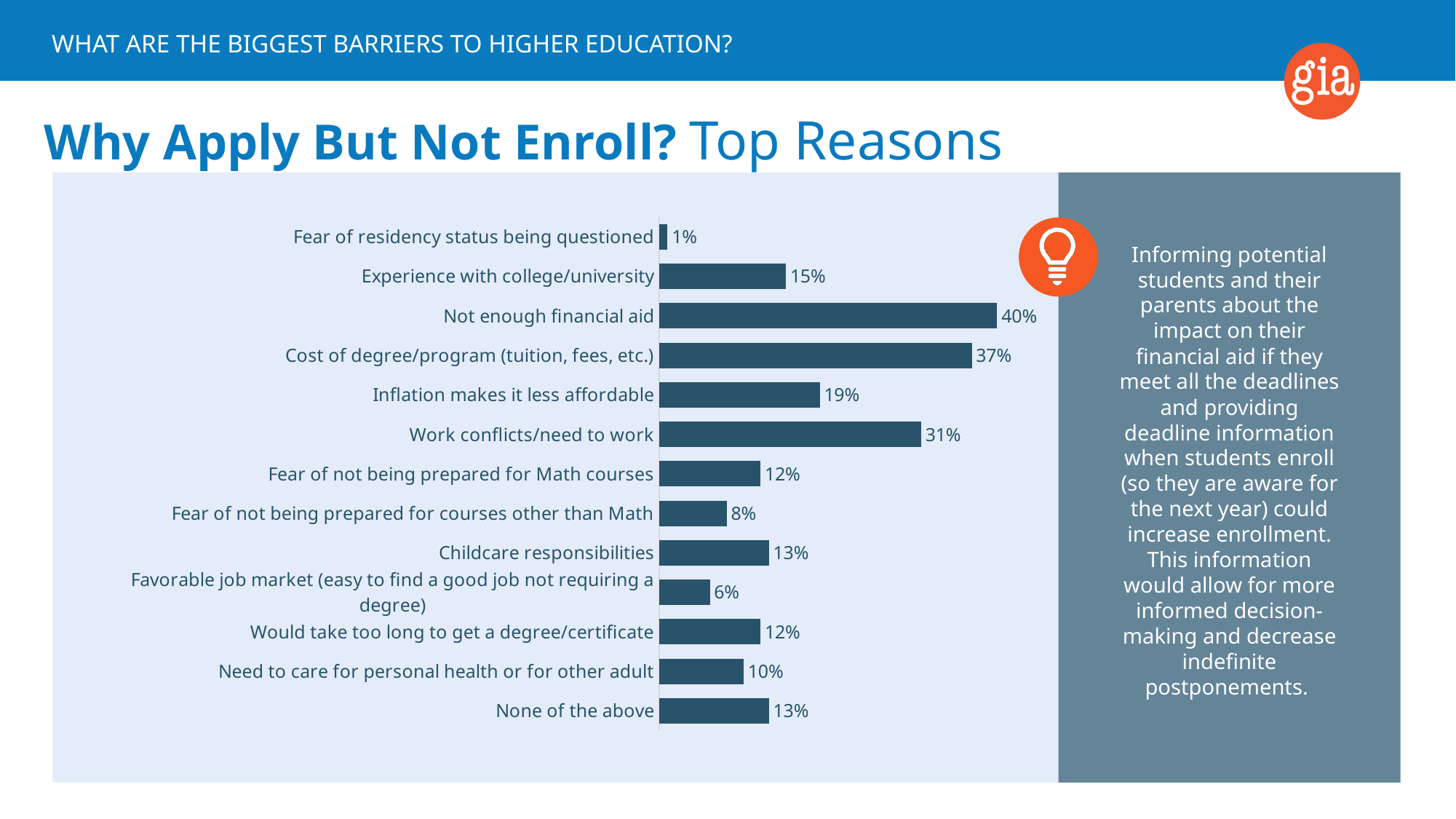
Which is larger: "Childcare responsibilities" or "Fear of not being prepared for courses other than Math"? Childcare responsibilities What is the difference between "Not enough financial aid" and "Cost of degree/program (tuition, fees, etc.)"? 3% What is the difference between "Work conflicts/need to work" and "Inflation makes it less affordable"? 12% What is the value for "Work conflicts/need to work"? 31% What percentage of respondents cited "Not enough financial aid" as a reason for not enrolling? 40% What is the value for "Inflation makes it less affordable"? 19% What percentage is shown for "Fear of residency status being questioned"? 1% What type of chart is shown on the slide? Bar chart What is the title of the slide containing the chart? Why Apply But Not Enroll? Top Reasons How many reasons (categories) are shown in the chart? 13 Which reason has the lowest percentage? Fear of residency status being questioned Which reason has the highest percentage? Not enough financial aid